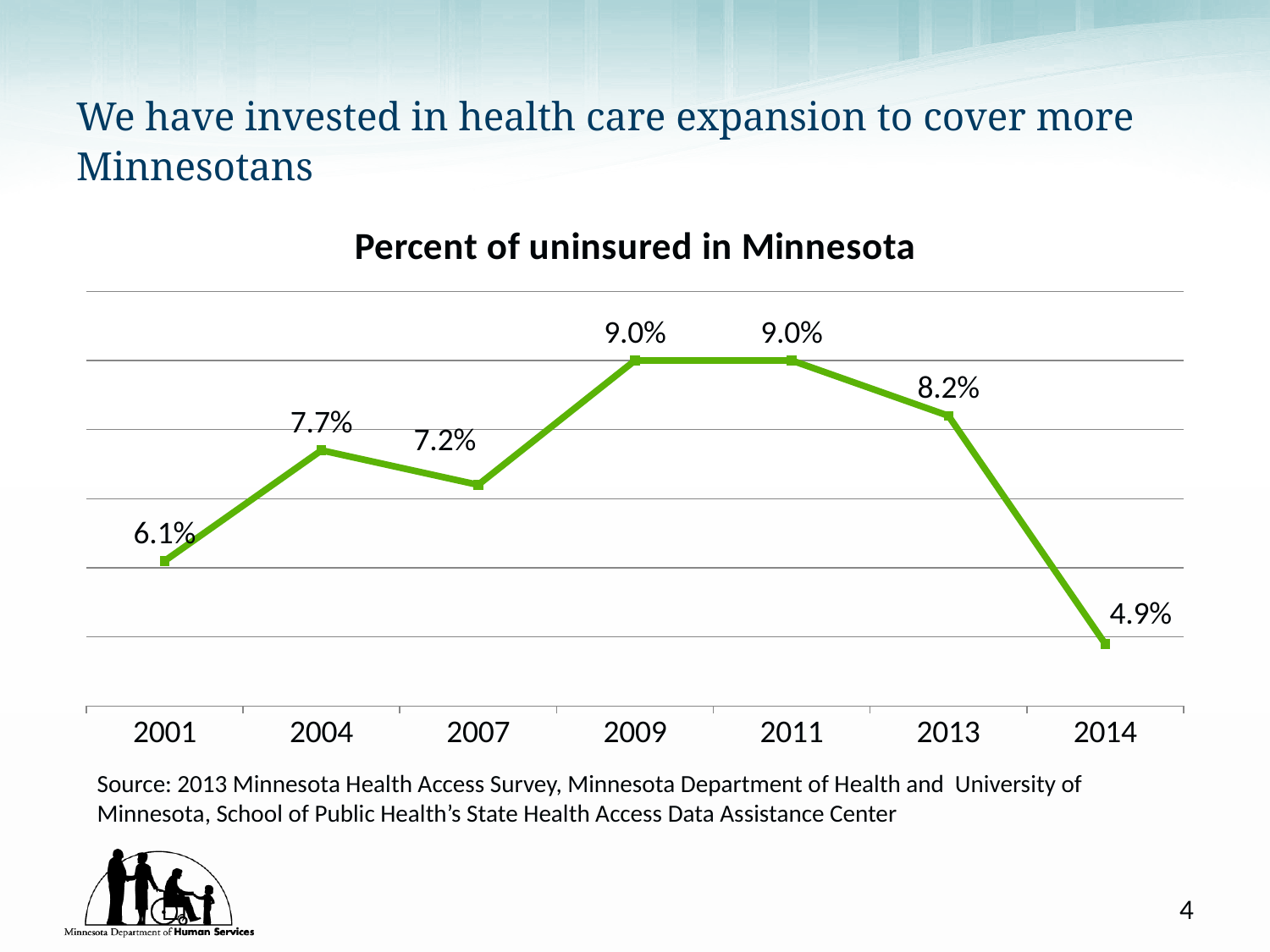
What is the difference between the percent of uninsured in 2004 and in 2007? 0.5% What is the highest percent of uninsured shown on the chart? 9.0% What is the title of the chart? Percent of uninsured in Minnesota Which year has a higher percent of uninsured, 2004 or 2007? 2004 What is the percent of uninsured in Minnesota in 2007? 7.2% What is the difference between the percent of uninsured in 2013 and in 2014? 3.3% What kind of chart is shown on the slide? Line chart What is the percent of uninsured in Minnesota in 2014? 4.9% What is the percent of uninsured in Minnesota in 2013? 8.2% Which year has the lowest percent of uninsured in Minnesota? 2014 What is the percent of uninsured in Minnesota in 2001? 6.1% How many years are plotted on the chart? 7